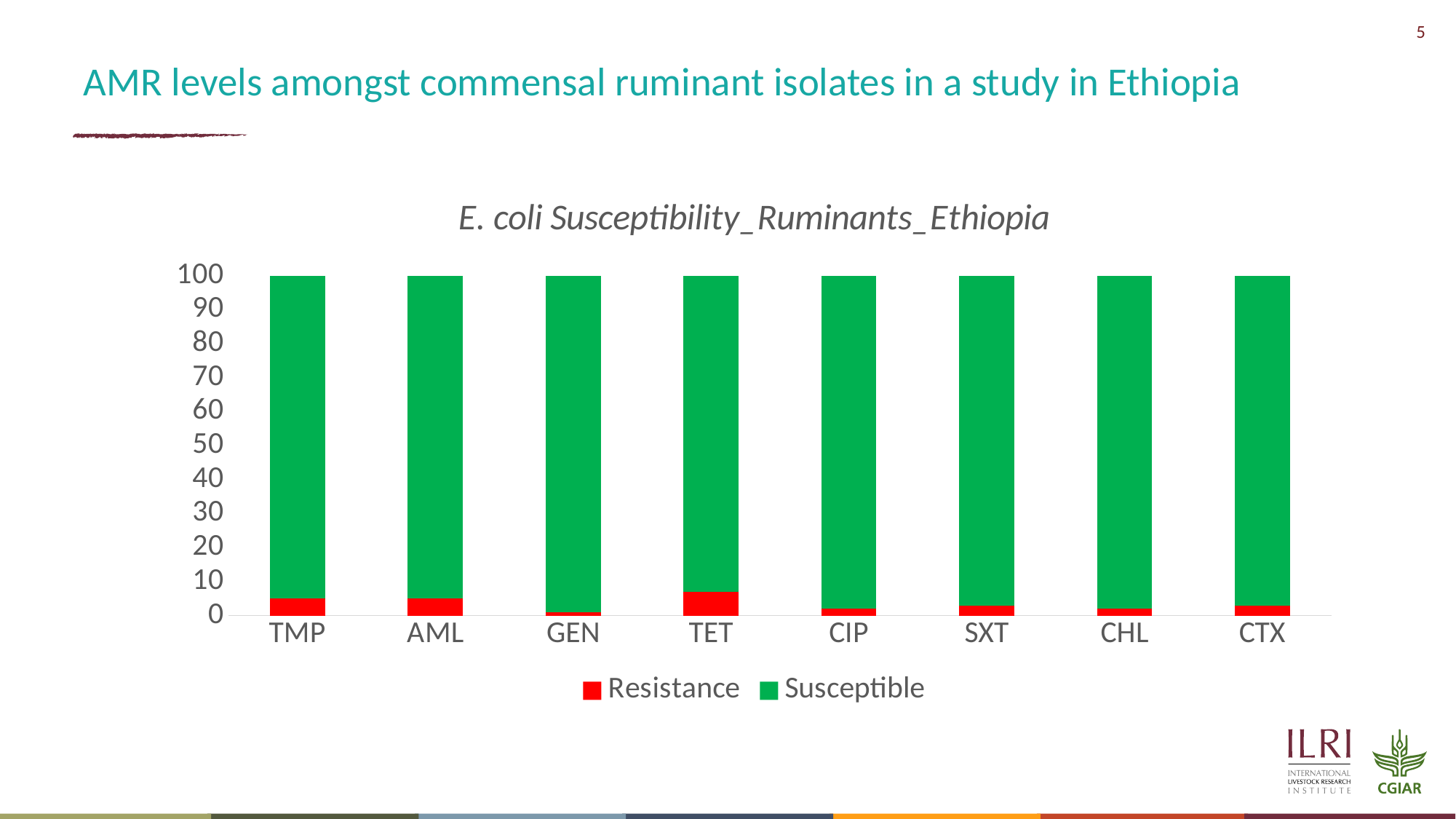
What is the title of the chart? E. coli Susceptibility_Ruminants_Ethiopia What kind of chart is shown on the slide? Stacked bar chart How many antibiotic categories are shown on the x axis? 8 Is the Resistance value for TET greater or less than 10? less Is the Susceptible value for GEN greater or less than 90? greater Which colour represents the Resistance series in the legend? Red Which antibiotic has the lowest Resistance value? GEN Which has the larger Susceptible value, GEN or TET? GEN What is the total height of the stacked bar for TMP? 100 How many series does the legend list? 2 Which antibiotic has the highest Resistance value? TET Which has the larger Resistance value, TET or GEN? TET